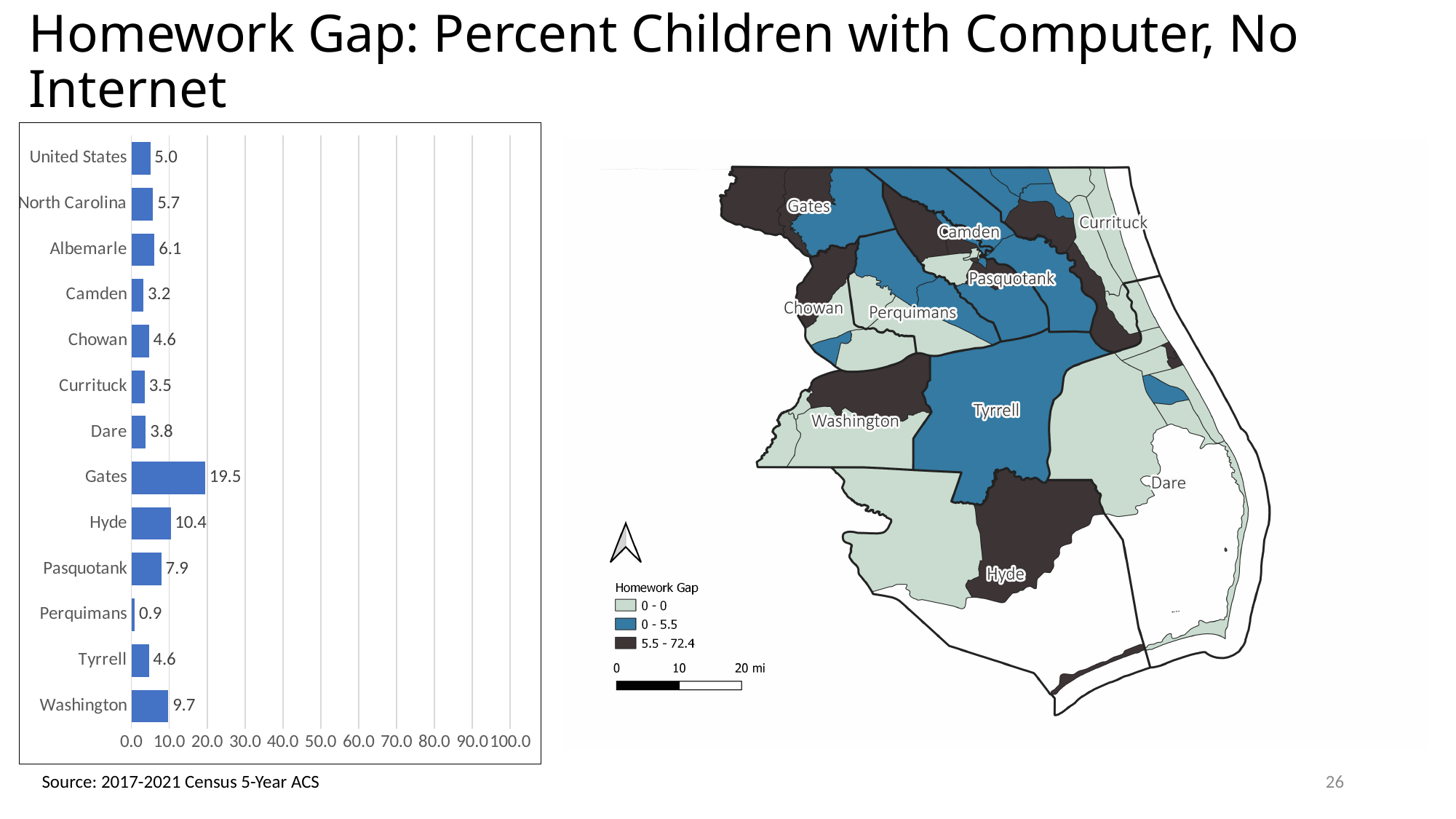
Which has a larger value in the bar chart, Washington or Pasquotank? Washington What is the value for Camden in the bar chart? 3.2 How many categories are shown in the bar chart? 13 What is the value for Gates in the bar chart? 19.5 What is the difference between the values for Gates and Hyde in the bar chart? 9.1 Which category has the highest value in the bar chart? Gates What kind of chart is on the left of the slide? bar chart Is the value for Hyde in the bar chart greater or less than 10.0? greater What is the value for Perquimans in the bar chart? 0.9 What is the highest value shown on the x axis of the bar chart? 100.0 What is the value for North Carolina in the bar chart? 5.7 Which category has the lowest value in the bar chart? Perquimans